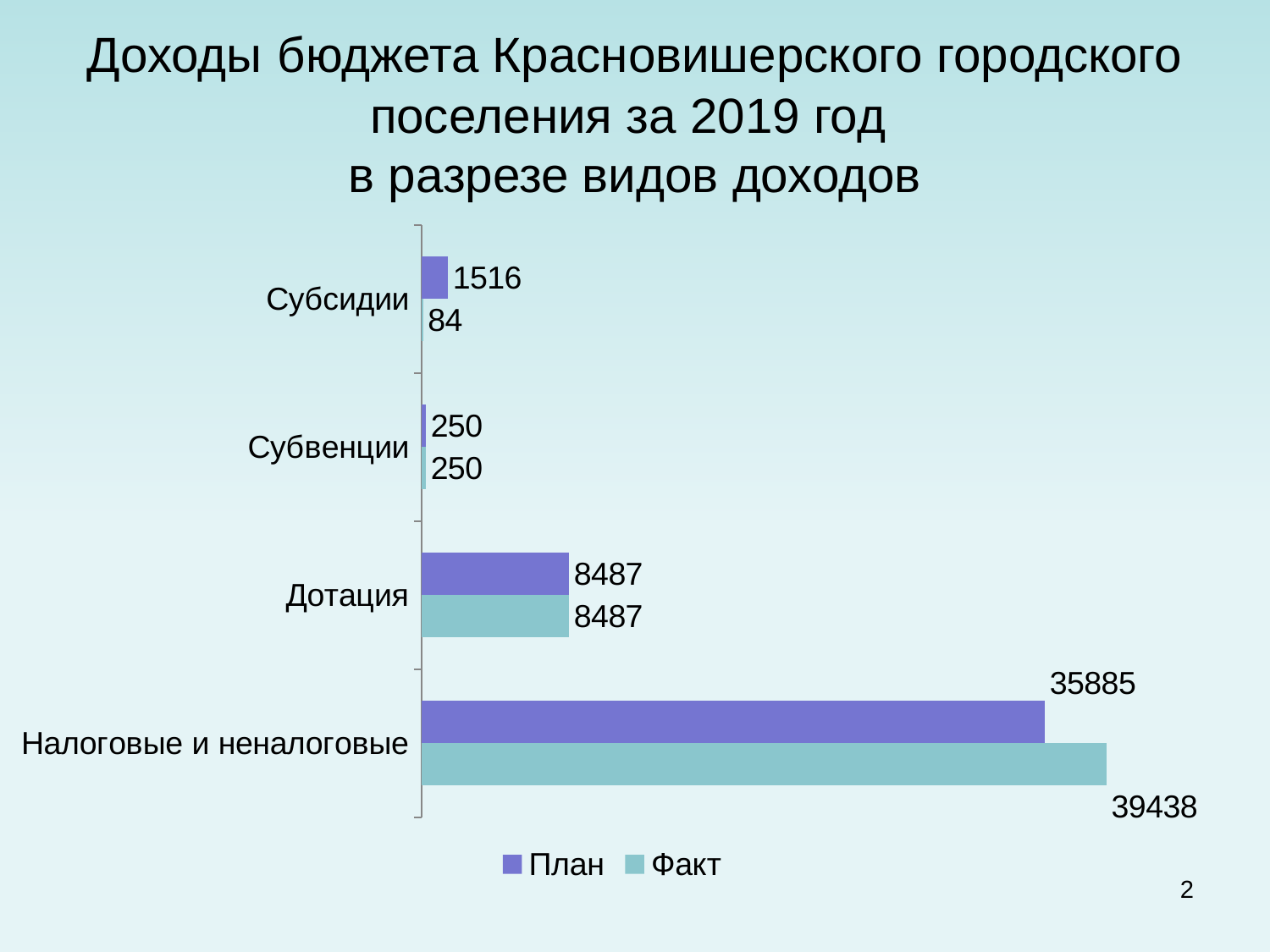
How many series does the legend list? 2 For Субсидии, which is larger: План or Факт? План What is the difference between the Факт and План values for Налоговые и неналоговые? 3553 How many categories are shown in the chart? 4 What is the План value for Налоговые и неналоговые? 35885 What is the Факт value for Дотация? 8487 What is the План value for Субсидии? 1516 Which category has the lowest Факт value? Субсидии Which category has the highest Факт value? Налоговые и неналоговые What is the Факт value for Налоговые и неналоговые? 39438 What is the Факт value for Субсидии? 84 What is the difference between the План and Факт values for Субсидии? 1432